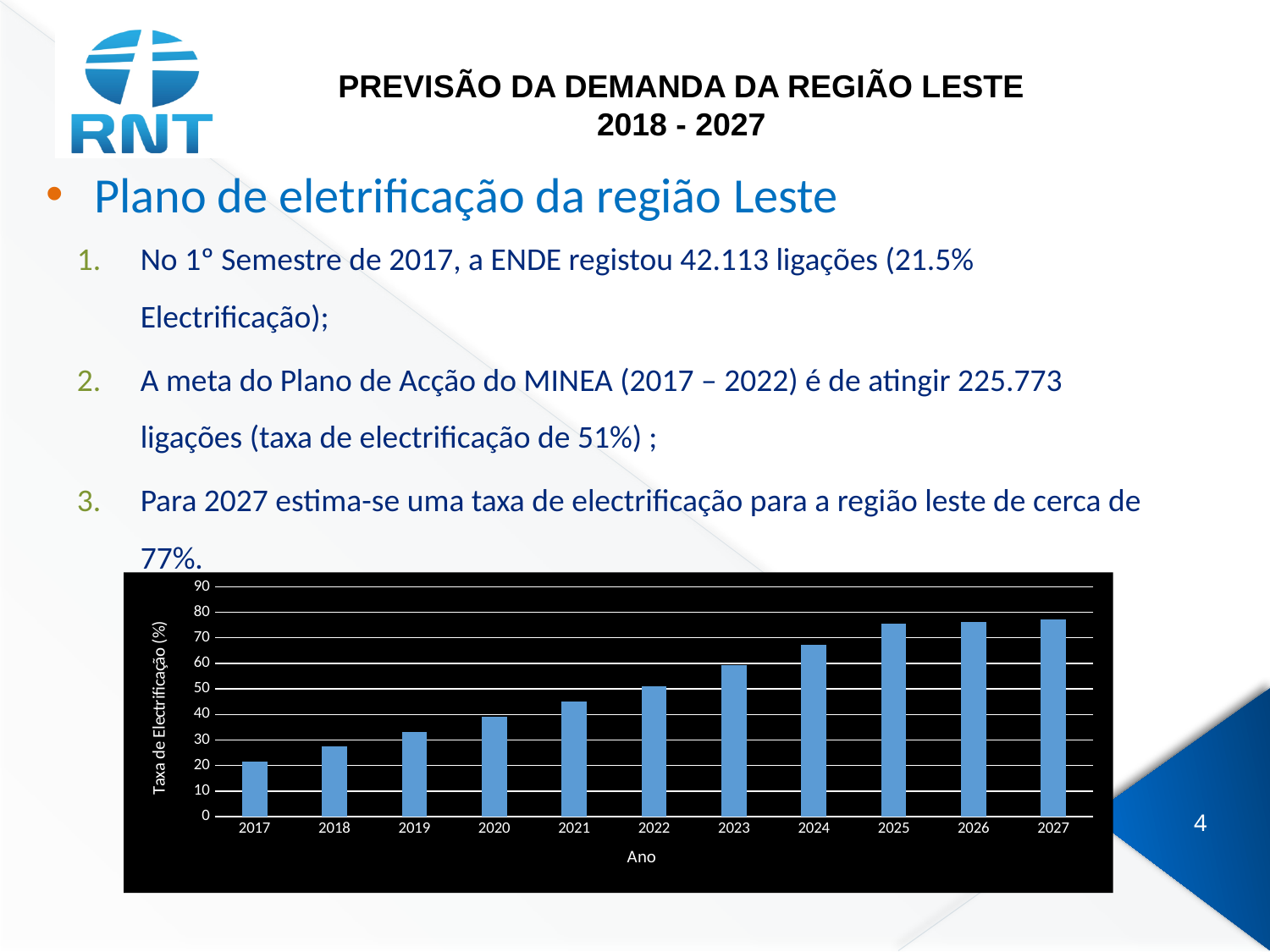
Is the value for 2022 greater or less than 40? greater Is the value for 2017 greater or less than 30? less What kind of chart is shown on the slide? bar chart Which is larger in the chart, the value for 2020 or the value for 2024? 2024 Do the values in the chart rise or fall from 2017 to 2027? rise Which year has the lowest electrification rate in the chart? 2017 Is the value for 2019 greater or less than 40? less How many years are plotted on the x axis of the chart? 11 What is the label of the vertical axis of the chart? Taxa de Electrificação (%) What is the label of the horizontal axis of the chart? Ano